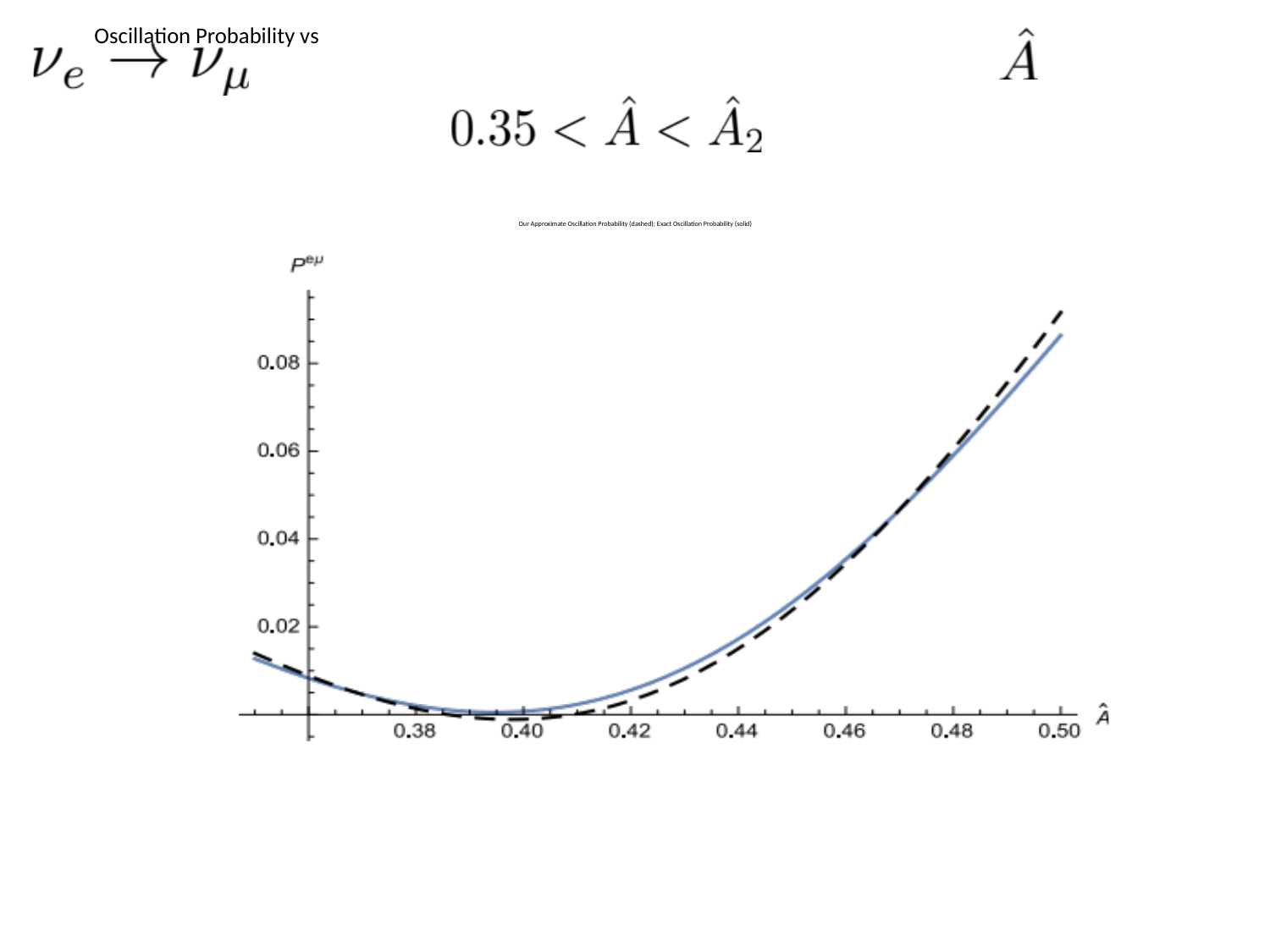
At Â = 0.44, which curve has the higher value, the dashed or the solid? solid Do the curves rise or fall as Â increases from 0.36 to 0.40? fall Is the value of the solid curve at Â = 0.40 greater or less than 0.02? less How many curves are plotted on the chart? 2 At Â = 0.50, which curve has the higher value, the dashed or the solid? dashed What kind of chart is shown on the slide? line chart Is the value of the dashed curve at Â = 0.50 greater or less than 0.08? greater Do the curves rise or fall as Â increases from 0.40 to 0.50? rise According to the chart caption, which line style represents the exact oscillation probability? solid Is the value of the solid curve at Â = 0.50 greater or less than 0.08? greater According to the chart caption, which line style represents the approximate oscillation probability? dashed